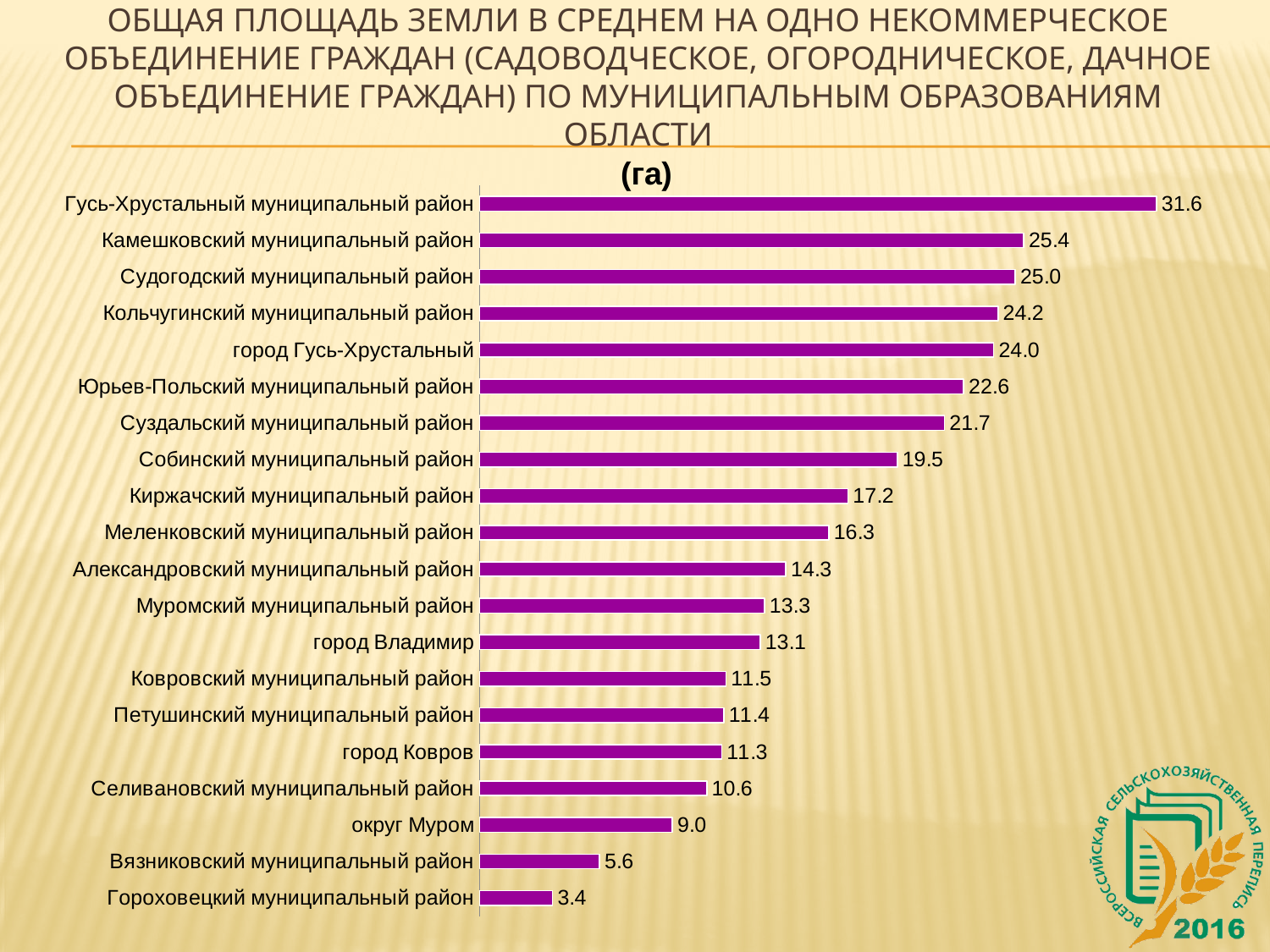
How many categories are shown in the chart? 20 What unit is shown in the chart's title above the bars? га What kind of chart is shown on the slide? Bar chart Which category has the highest value? Гусь-Хрустальный муниципальный район Which category has the lowest value? Гороховецкий муниципальный район Which is larger, the value for округ Муром or the value for Вязниковский муниципальный район? округ Муром What is the difference between the values for Гусь-Хрустальный муниципальный район and Гороховецкий муниципальный район? 28.2 What is the difference between the values for Камешковский муниципальный район and Судогодский муниципальный район? 0.4 What is the value for Селивановский муниципальный район? 10.6 What is the value for Гусь-Хрустальный муниципальный район? 31.6 Which is larger, the value for Собинский муниципальный район or the value for Киржачский муниципальный район? Собинский муниципальный район What is the value for город Владимир? 13.1